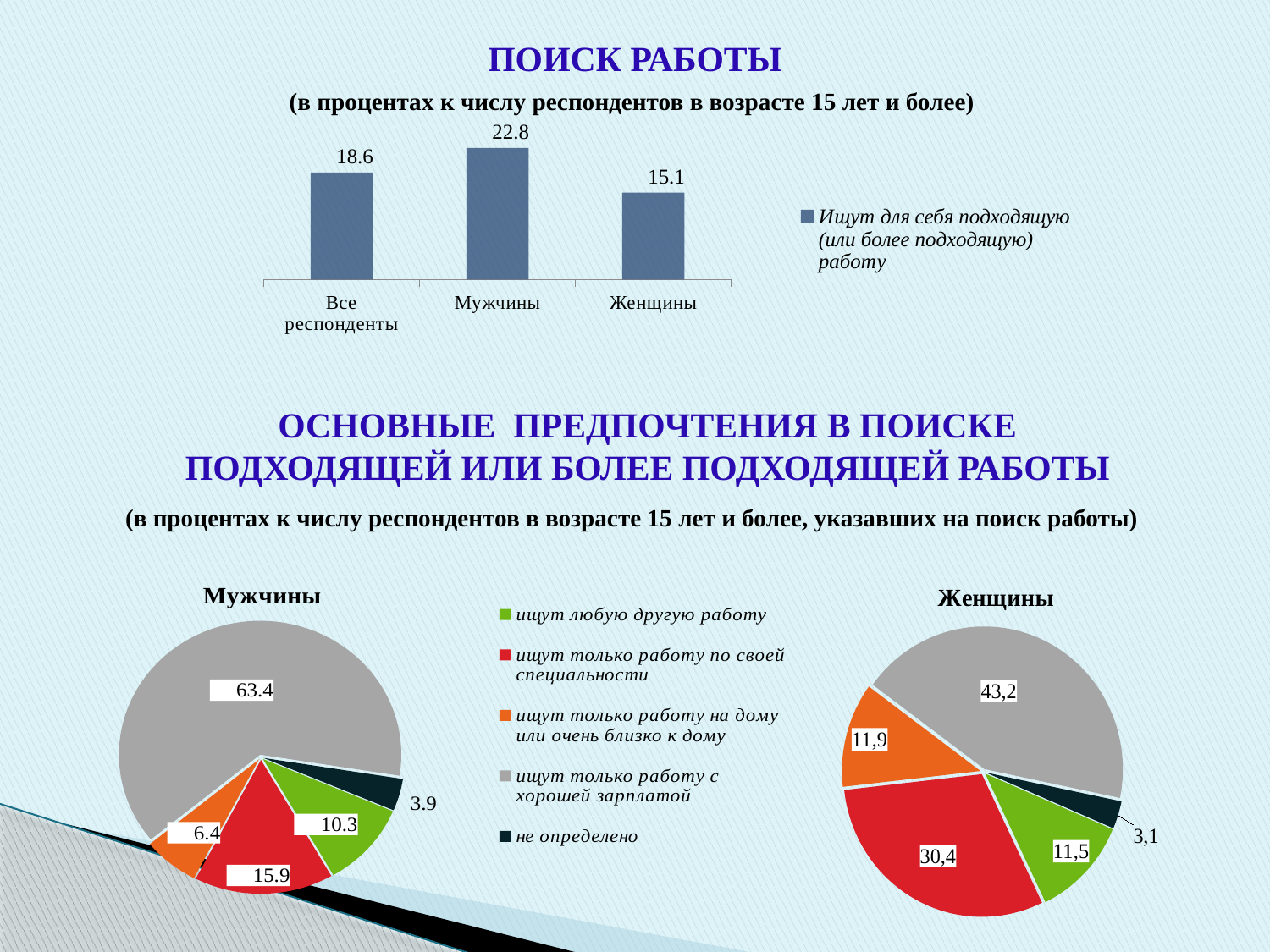
How many entries does the legend of the pie charts list? 5 What type of chart is the top chart 'ПОИСК РАБОТЫ'? bar chart In the bar chart 'ПОИСК РАБОТЫ', what is the value for Мужчины? 22.8 In the pie chart 'Мужчины', what is the value of the slice for 'ищут только работу по своей специальности'? 15.9 In the bar chart 'ПОИСК РАБОТЫ', how many categories are shown on the x axis? 3 In the bar chart 'ПОИСК РАБОТЫ', what is the value for Женщины? 15.1 In the bar chart 'ПОИСК РАБОТЫ', which category has the highest value? Мужчины In the bar chart 'ПОИСК РАБОТЫ', what is the difference between the values for Мужчины and Женщины? 7.7 In the pie chart 'Мужчины', what is the value of the slice for 'ищут только работу с хорошей зарплатой'? 63.4 In the pie chart 'Женщины', what is the value of the slice for 'ищут только работу на дому или очень близко к дому'? 11,9 Which is larger: the 'ищут только работу по своей специальности' slice in the 'Мужчины' pie chart or in the 'Женщины' pie chart? Женщины In the pie chart 'Женщины', which slice is the smallest? не определено